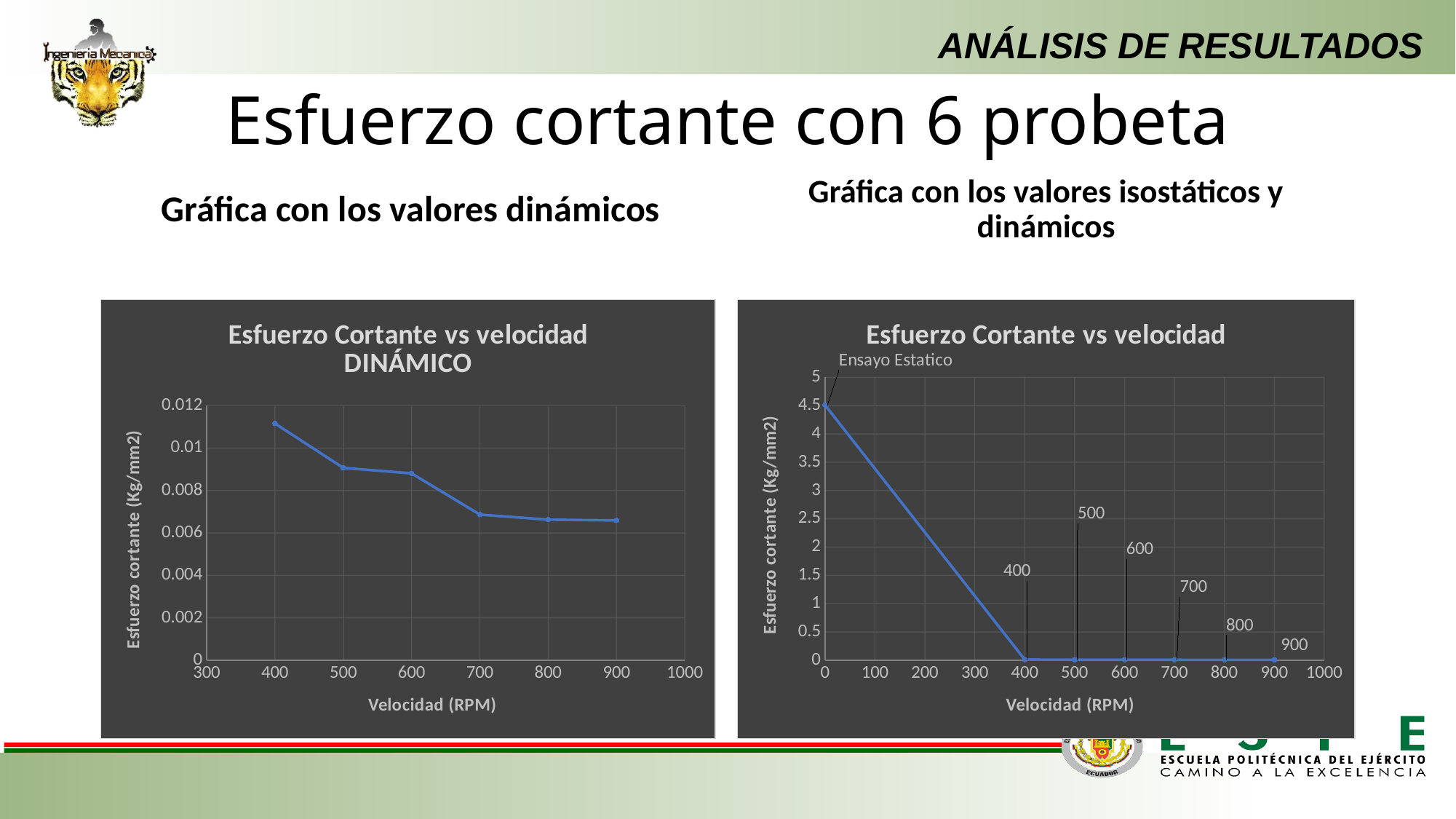
How many data points are plotted on the left chart 'Esfuerzo Cortante vs velocidad DINÁMICO'? 6 What is the y-axis title of the left chart 'Esfuerzo Cortante vs velocidad DINÁMICO'? Esfuerzo cortante (Kg/mm2) On the left chart 'Esfuerzo Cortante vs velocidad DINÁMICO', which is larger, the value at 500 RPM or the value at 800 RPM? 500 RPM On the left chart 'Esfuerzo Cortante vs velocidad DINÁMICO', is the value at 700 RPM greater or less than 0.008? less On the right chart 'Esfuerzo Cortante vs velocidad', is the value of the 'Ensayo Estatico' point at 0 RPM greater or less than 4? greater On the left chart 'Esfuerzo Cortante vs velocidad DINÁMICO', is the value at 400 RPM greater or less than 0.01? greater What kind of chart is the left chart titled 'Esfuerzo Cortante vs velocidad DINÁMICO'? line chart On the left chart 'Esfuerzo Cortante vs velocidad DINÁMICO', at which velocity (RPM) is the shear stress highest? 400 On the right chart 'Esfuerzo Cortante vs velocidad', which point has the highest shear stress? Ensayo Estatico (0 RPM) What is the x-axis title of the right chart 'Esfuerzo Cortante vs velocidad'? Velocidad (RPM) On the left chart 'Esfuerzo Cortante vs velocidad DINÁMICO', do the values rise or fall as velocity increases from 400 to 900 RPM? fall